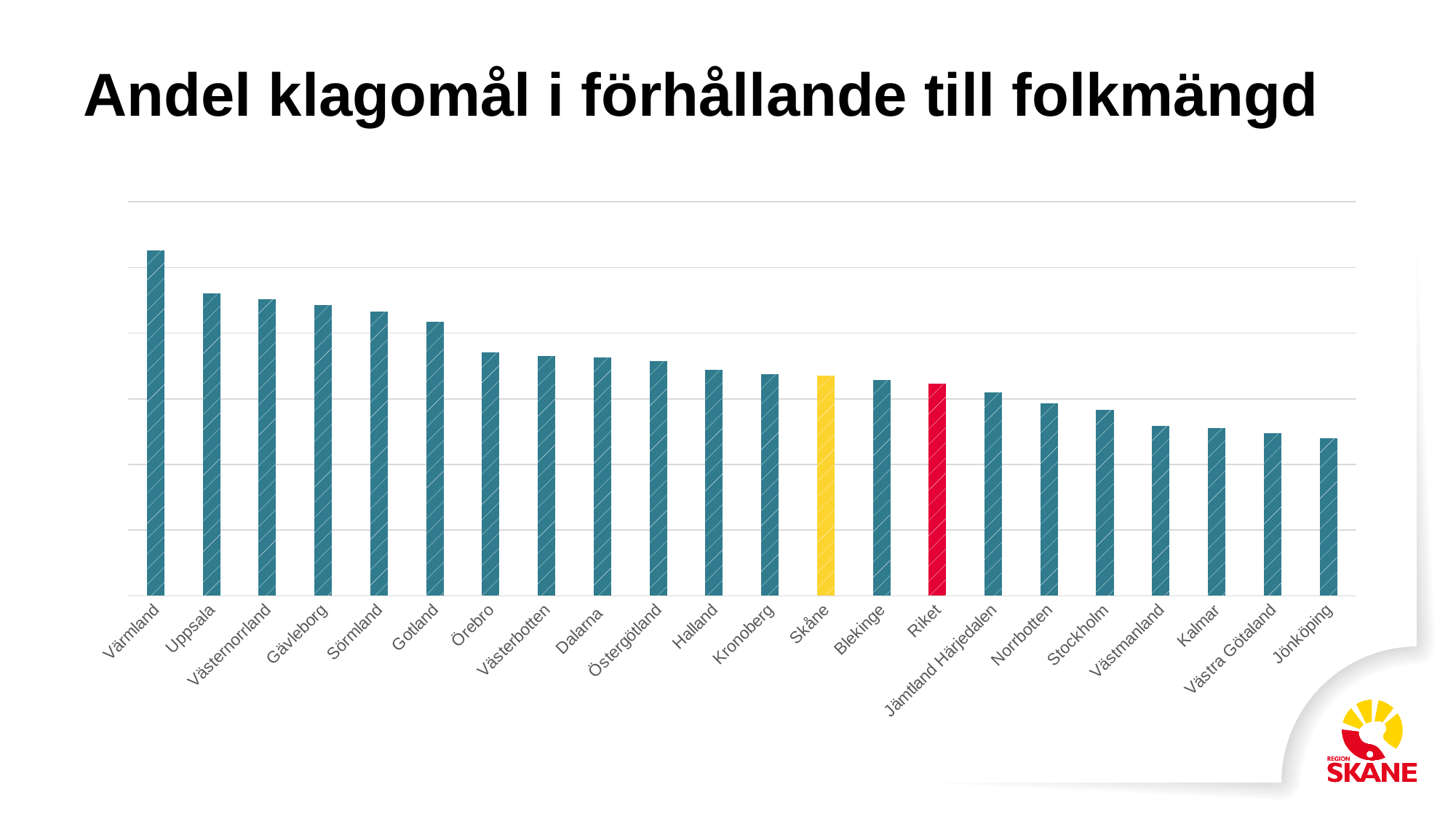
Do the values rise or fall from left to right along the x axis? fall Which has a larger value, Stockholm or Uppsala? Uppsala Which has a larger value, Kalmar or Sörmland? Sörmland Which has a larger value, Värmland or Jönköping? Värmland What kind of chart is shown on the slide? bar chart How many categories (bars) are shown in the chart? 22 Which category has the highest value in the chart? Värmland What is the title of the chart? Andel klagomål i förhållande till folkmängd Which category is highlighted with a yellow bar? Skåne Which category has the lowest value in the chart? Jönköping